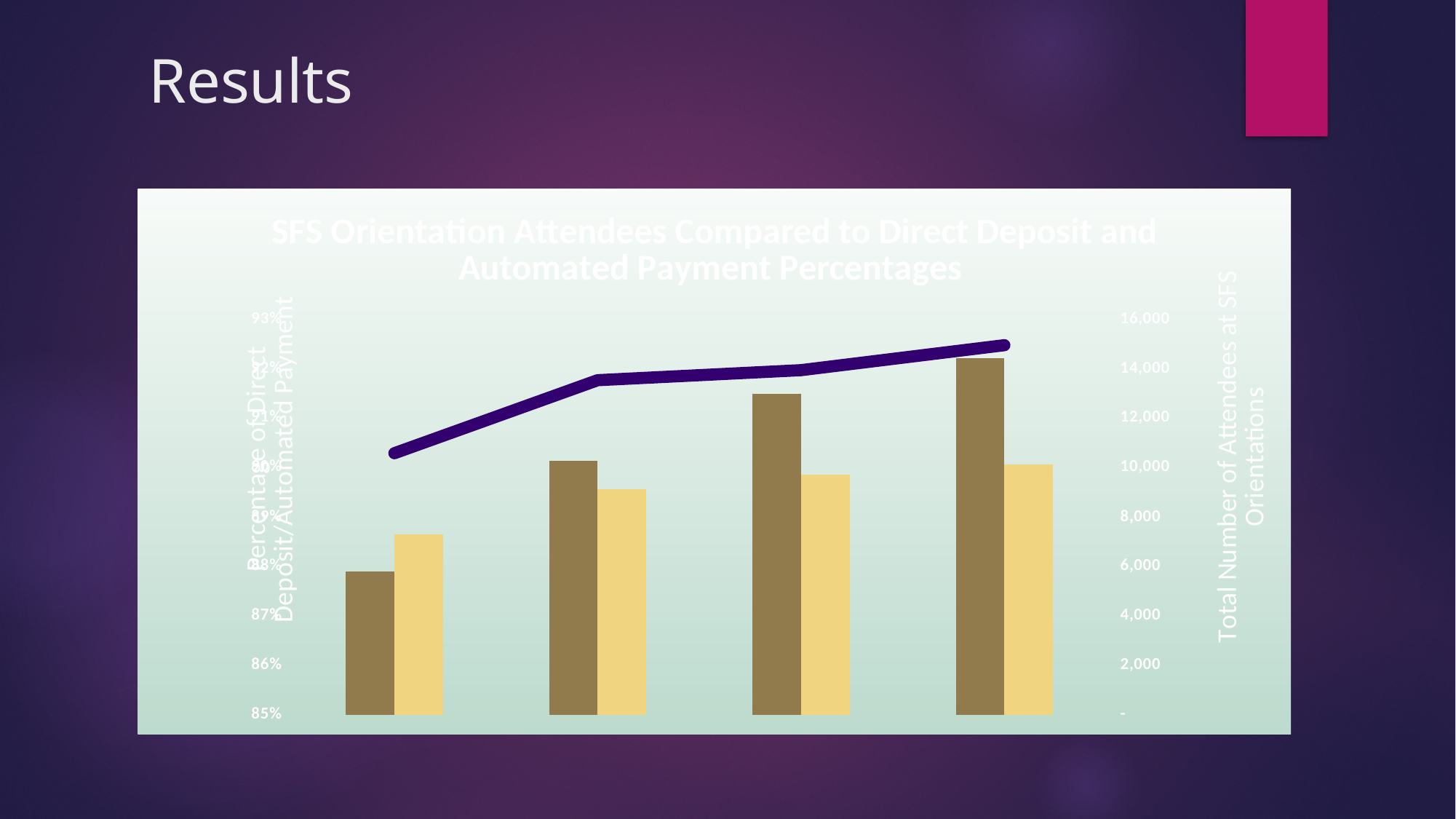
What is the highest value shown on the right vertical axis of the chart? 16,000 What kind of chart is shown on the slide? Combination bar and line chart Which group of bars has the shortest light yellow bar? The leftmost group What is the highest value shown on the left vertical axis of the chart? 93% Do the dark gold bars rise or fall from left to right across the chart? Rise Do the light yellow bars rise or fall from left to right across the chart? Rise How many groups of bars are plotted in the chart? 4 What is the title of the chart? SFS Orientation Attendees Compared to Direct Deposit and Automated Payment Percentages Does the line in the chart rise or fall from left to right? Rises How many bar series are plotted in the chart? 2 Which group of bars has the tallest dark gold bar: the leftmost or the rightmost? Rightmost